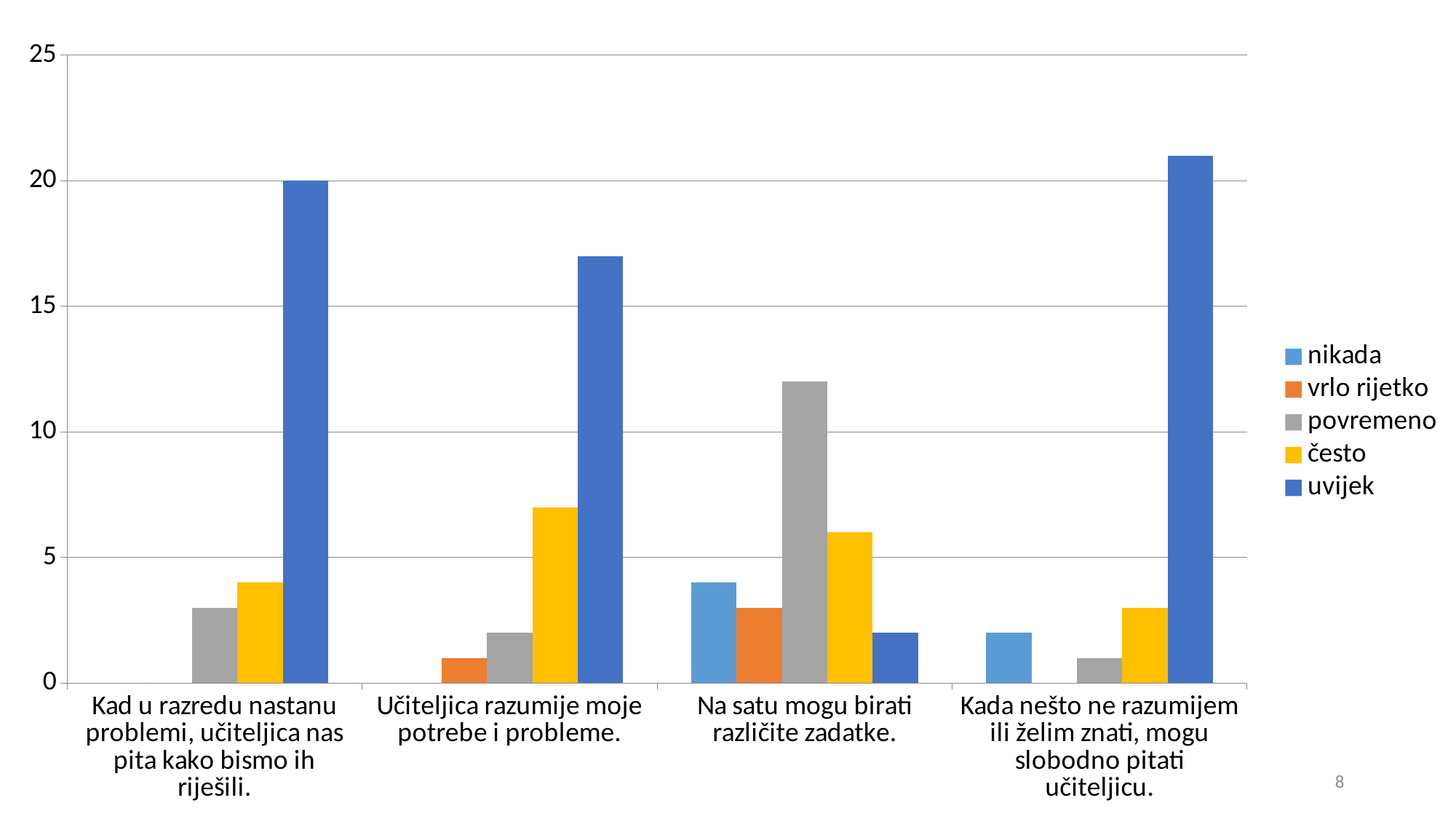
What kind of chart is shown on the slide? bar chart Which series has the highest value for "Na satu mogu birati različite zadatke."? povremeno Is the value of "uvijek" for "Kada nešto ne razumijem ili želim znati, mogu slobodno pitati učiteljicu." greater or less than 20? greater How many categories are shown on the x axis? 4 For "Učiteljica razumije moje potrebe i probleme.", which is larger: "često" or "povremeno"? često Is the value of "povremeno" for "Na satu mogu birati različite zadatke." greater or less than 10? greater Which legend entry is shown in yellow? često Which category has the lowest "uvijek" value? Na satu mogu birati različite zadatke. How many series does the legend list? 5 Is the value of "uvijek" for "Učiteljica razumije moje potrebe i probleme." greater or less than 15? greater What is the value of "uvijek" for "Kad u razredu nastanu problemi, učiteljica nas pita kako bismo ih riješili."? 20 Which category has the highest "uvijek" value? Kada nešto ne razumijem ili želim znati, mogu slobodno pitati učiteljicu.